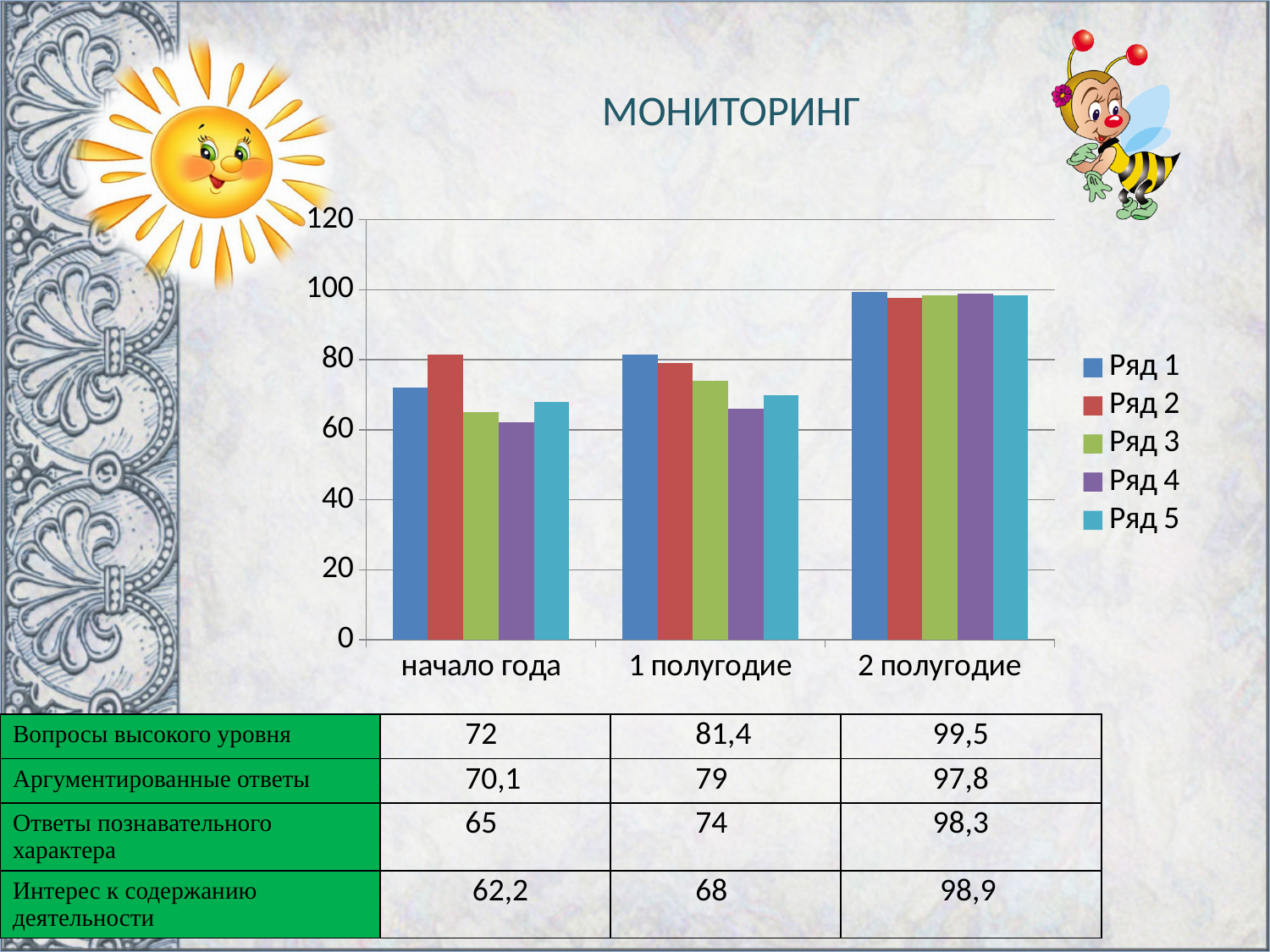
Is the value for Ряд 5 at 2 полугодие greater or less than 80? greater Is the value for Ряд 3 at 1 полугодие greater or less than 80? less How many categories are shown on the x axis of the chart? 3 How many series does the chart legend list? 5 What is the title shown above the chart? МОНИТОРИНГ Do the values for Ряд 1 rise or fall from начало года to 2 полугодие? rise Which series has the highest value at начало года? Ряд 2 Which series has the lowest value at начало года? Ряд 4 At начало года, which is larger: Ряд 1 or Ряд 4? Ряд 1 What kind of chart is shown on the slide? bar chart What colour are the bars for Ряд 2 in the chart? red Is the value for Ряд 1 at начало года greater or less than 80? less